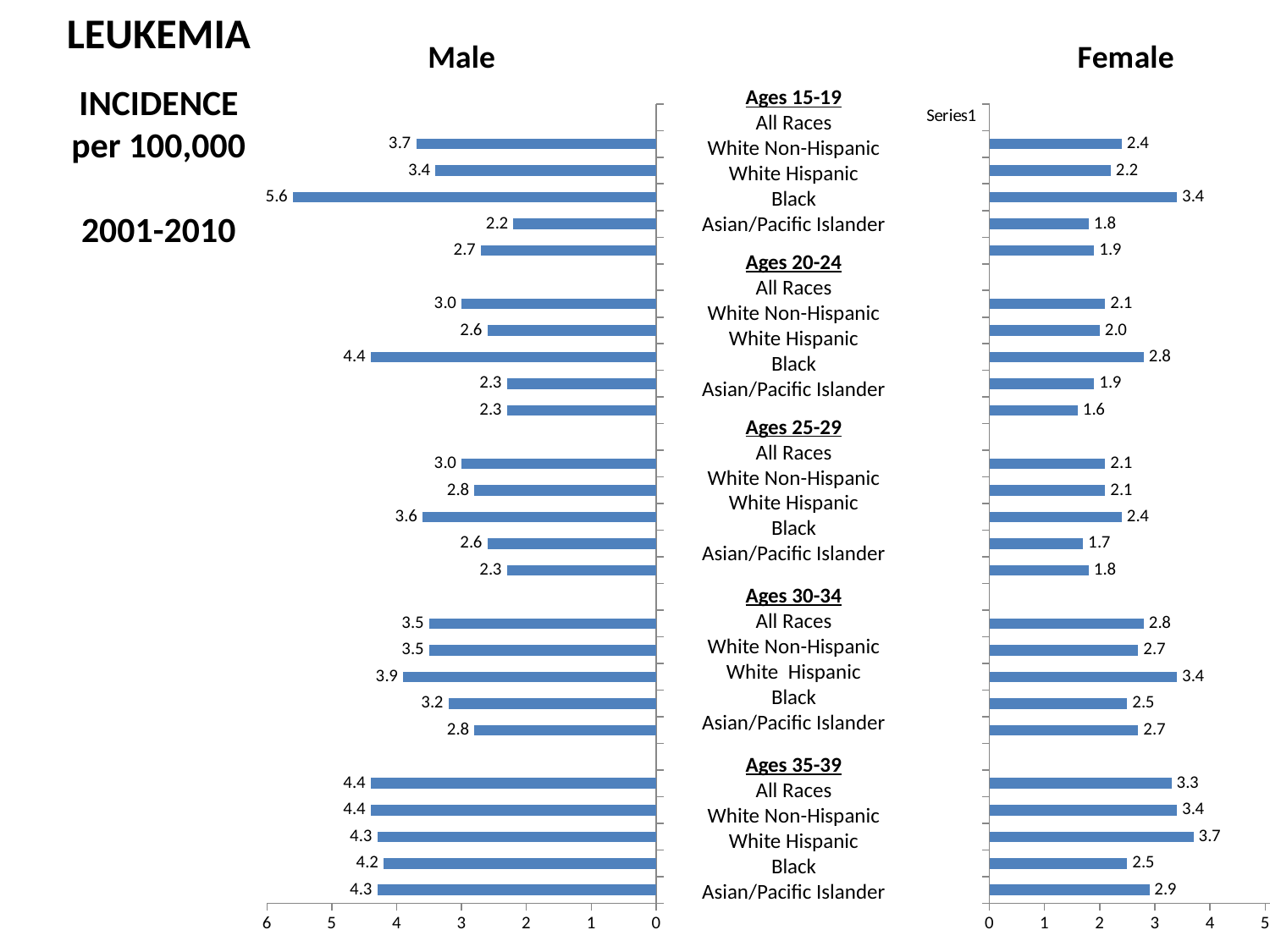
How many age groups are shown on the slide? 5 For Black individuals aged 20-24, which is larger, the male incidence or the female incidence? Male In the Female chart, what is the incidence for Asian/Pacific Islander females aged 20-24? 1.6 In the Female chart, which group has the lowest incidence? Asian/Pacific Islander, Ages 20-24 In the Female chart, which group has the highest incidence? White Hispanic, Ages 35-39 In the Male chart, what is the difference between the incidence for White Hispanic males aged 15-19 and Black males aged 15-19? 3.4 In the Male chart, which group has the highest incidence? White Hispanic, Ages 15-19 In the Male chart, what is the leukemia incidence for White Hispanic males aged 15-19? 5.6 In the Male chart, what is the incidence for All Races males aged 35-39? 4.4 In the Female chart, what is the incidence for Black females aged 15-19? 1.8 In the Female chart, is the incidence for White Hispanic females aged 30-34 greater or less than 3? greater What type of chart is used for the Male and Female data? Bar chart